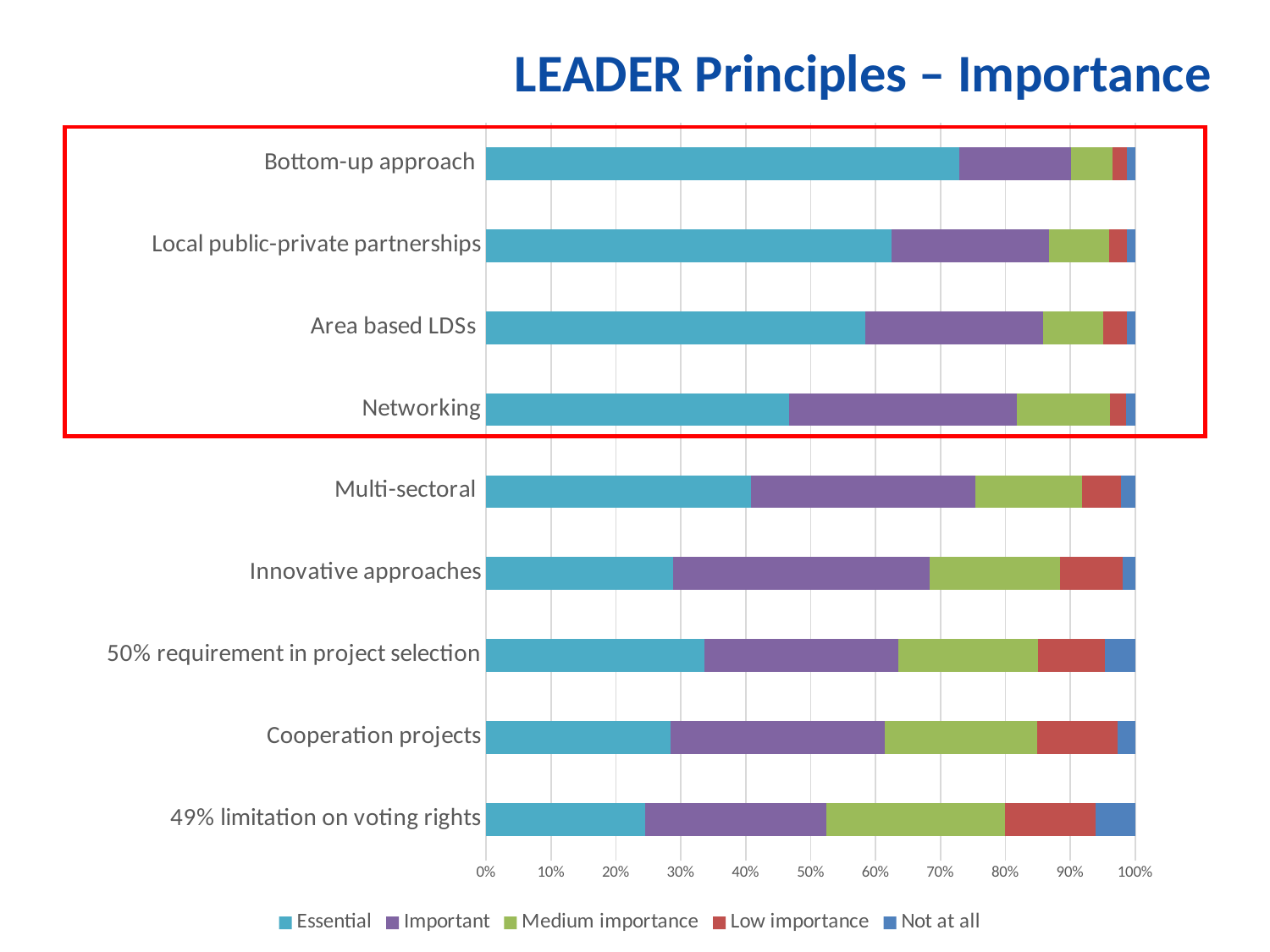
Which has the larger 'Essential' share: Multi-sectoral or Cooperation projects? Multi-sectoral Which principle has the largest 'Essential' share? Bottom-up approach How many LEADER principles (categories) are plotted on the chart? 9 Is the 'Essential' share for Networking greater or less than 50%? less What is the title of the chart? LEADER Principles – Importance Which legend entry is shown in red? Low importance How many series does the legend list? 5 Which principle has the smallest 'Essential' share? 49% limitation on voting rights Is the 'Essential' share for 49% limitation on voting rights greater or less than 30%? less What kind of chart is shown on the slide? Stacked bar chart Is the 'Essential' share for Local public-private partnerships greater or less than 60%? greater